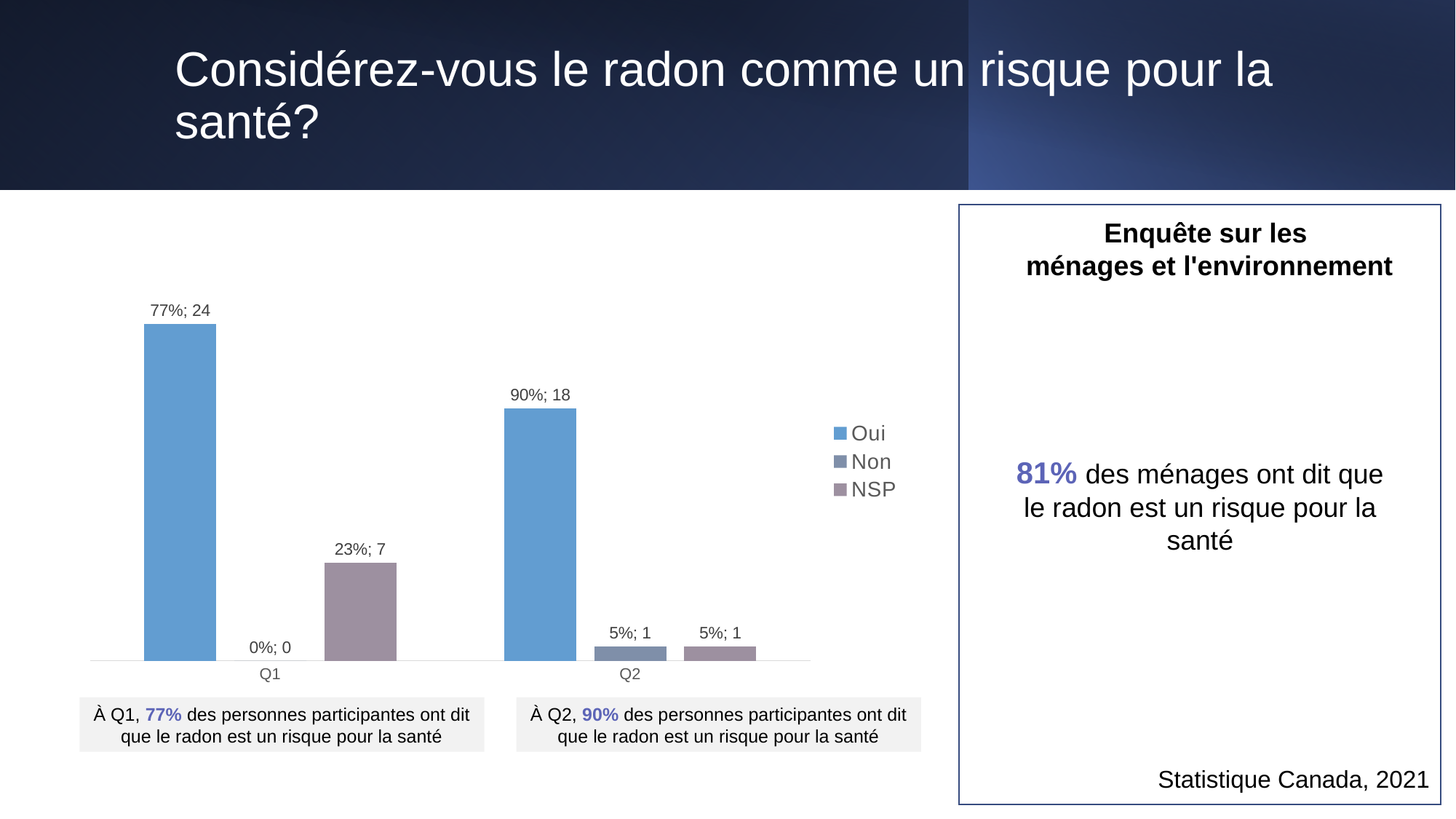
Which is larger, the NSP percentage at Q1 or the NSP percentage at Q2? NSP at Q1 What is the data label for Non at Q2? 5%; 1 Which series has the highest value at Q1? Oui How many categories are shown on the x axis? 2 Which series has the lowest value at Q1? Non What is the data label for Oui at Q2? 90%; 18 What is the data label for Non at Q1? 0%; 0 How many series does the legend list? 3 What is the data label for Oui at Q1? 77%; 24 What is the data label for NSP at Q1? 23%; 7 What kind of chart is shown on the slide? Bar chart What is the difference in count between Oui at Q1 and Oui at Q2? 6